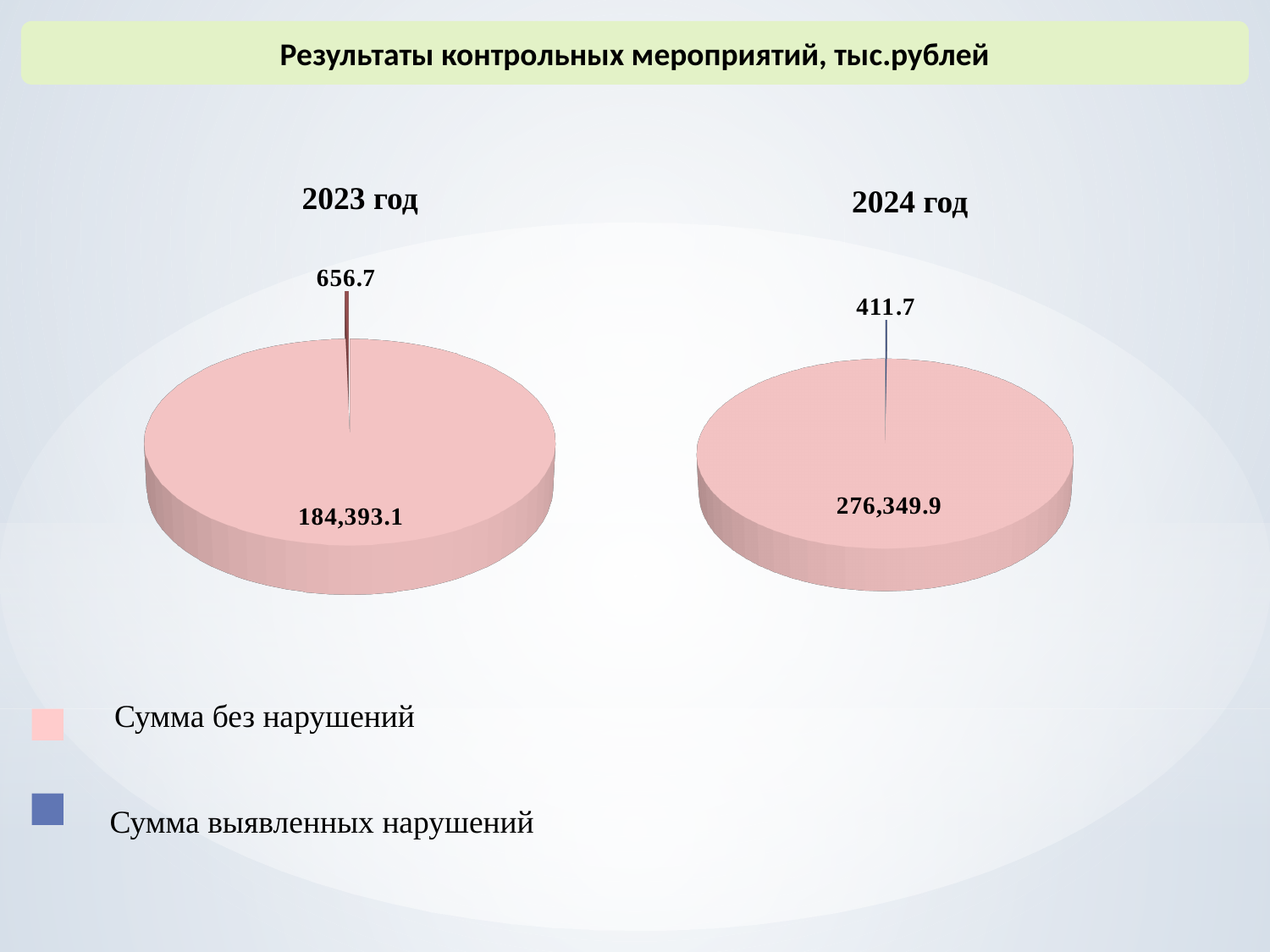
In the 2024 год chart, what is the value for Сумма без нарушений? 276,349.9 What is the difference between the Сумма выявленных нарушений values in the 2023 год chart and the 2024 год chart? 245.0 What type of chart is used for the 2023 год data? pie chart Comparing the two charts, which year has the larger value for Сумма выявленных нарушений, 2023 год or 2024 год? 2023 год What colour represents Сумма без нарушений in the legend? pink What is the total of the two values shown in the 2024 год chart? 276,761.6 How many entries does the legend list? 2 In the 2023 год chart, which category has the smallest slice? Сумма выявленных нарушений In the 2024 год chart, which category has the largest slice? Сумма без нарушений In the 2023 год chart, what is the value for Сумма выявленных нарушений? 656.7 In the 2024 год chart, what is the value for Сумма выявленных нарушений? 411.7 In the 2023 год chart, what is the value for Сумма без нарушений? 184,393.1